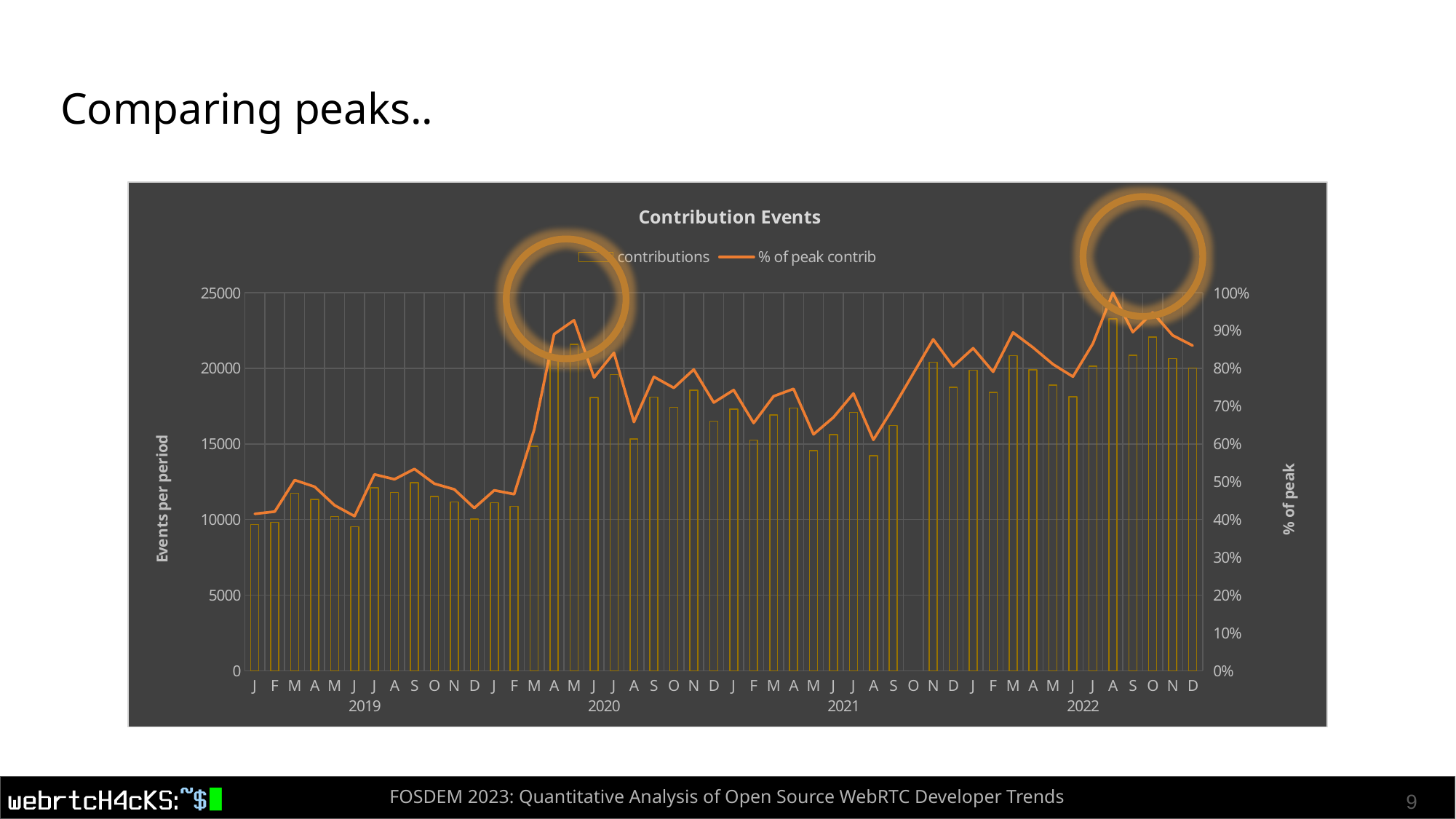
Is the % of peak contrib value for January 2019 greater or less than 50%? less How many monthly bars are plotted in the chart? 47 What is the value of % of peak contrib in August 2022? 100% In which month and year does the % of peak contrib line reach its highest value? August 2022 Do contributions generally rise or fall from 2019 to 2022? rise What is the title of the chart? Contribution Events Is the contributions value for January 2019 greater or less than 10000? less Which month has the higher contributions bar, May 2020 or August 2022? August 2022 Is the contributions value for August 2022 greater or less than 20000? greater Which years are shown along the x axis of the chart? 2019, 2020, 2021, 2022 How many series does the legend of the Contribution Events chart list? 2 What kind of chart is shown on the slide? Combined bar and line chart